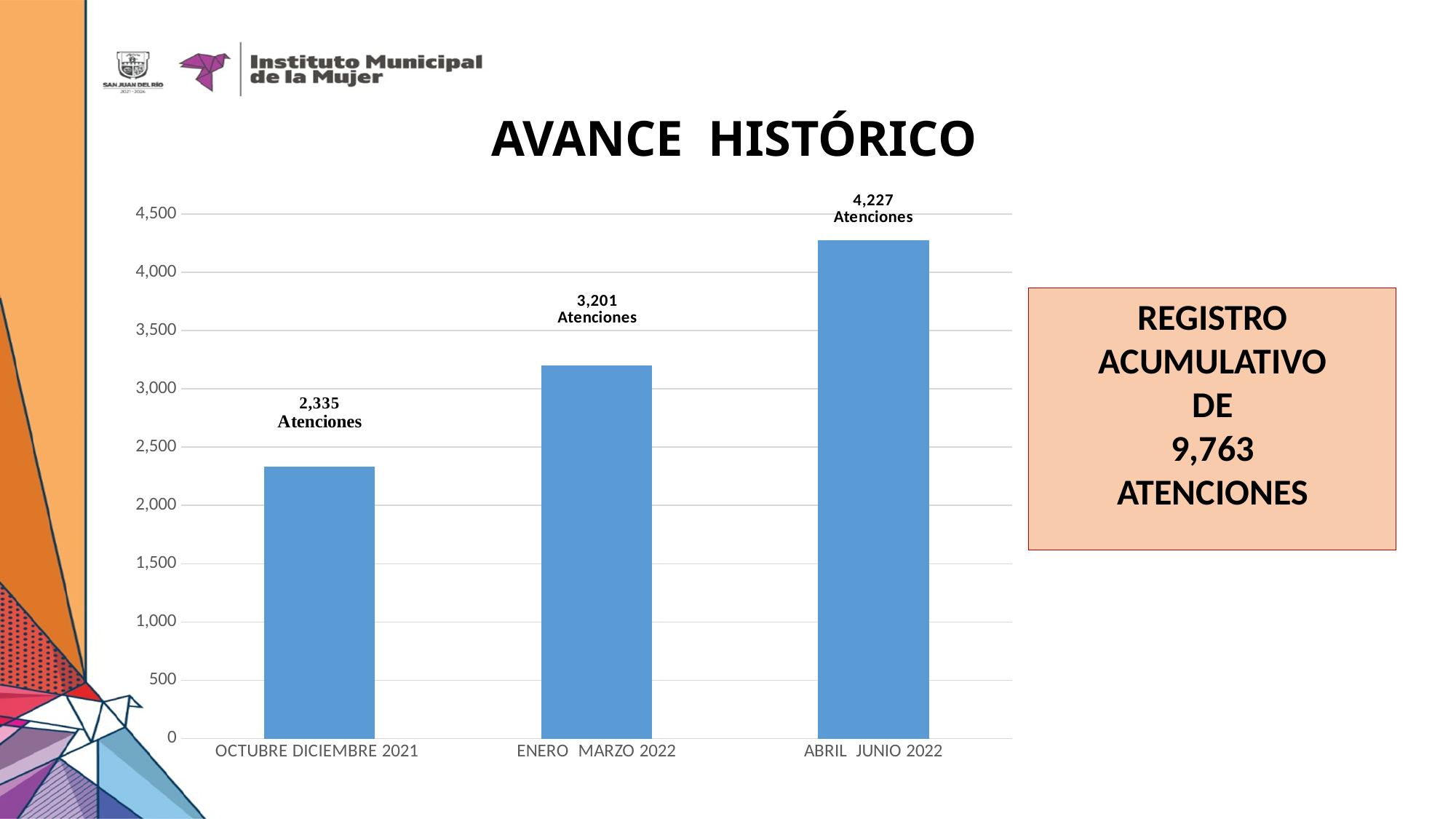
What kind of chart is shown on the slide? bar chart Which period has the lowest value? OCTUBRE DICIEMBRE 2021 Is the value for ENERO MARZO 2022 greater or less than 3,000? greater How many periods are shown on the x axis? 3 What is the value for OCTUBRE DICIEMBRE 2021? 2,335 What is the difference between the values for ABRIL JUNIO 2022 and OCTUBRE DICIEMBRE 2021? 1,892 Which is larger, the value for ENERO MARZO 2022 or the value for ABRIL JUNIO 2022? ABRIL JUNIO 2022 What is the difference between the values for ENERO MARZO 2022 and OCTUBRE DICIEMBRE 2021? 866 What is the value for ENERO MARZO 2022? 3,201 Do the values rise or fall from OCTUBRE DICIEMBRE 2021 to ABRIL JUNIO 2022? rise Which period has the highest value? ABRIL JUNIO 2022 What is the value for ABRIL JUNIO 2022? 4,227